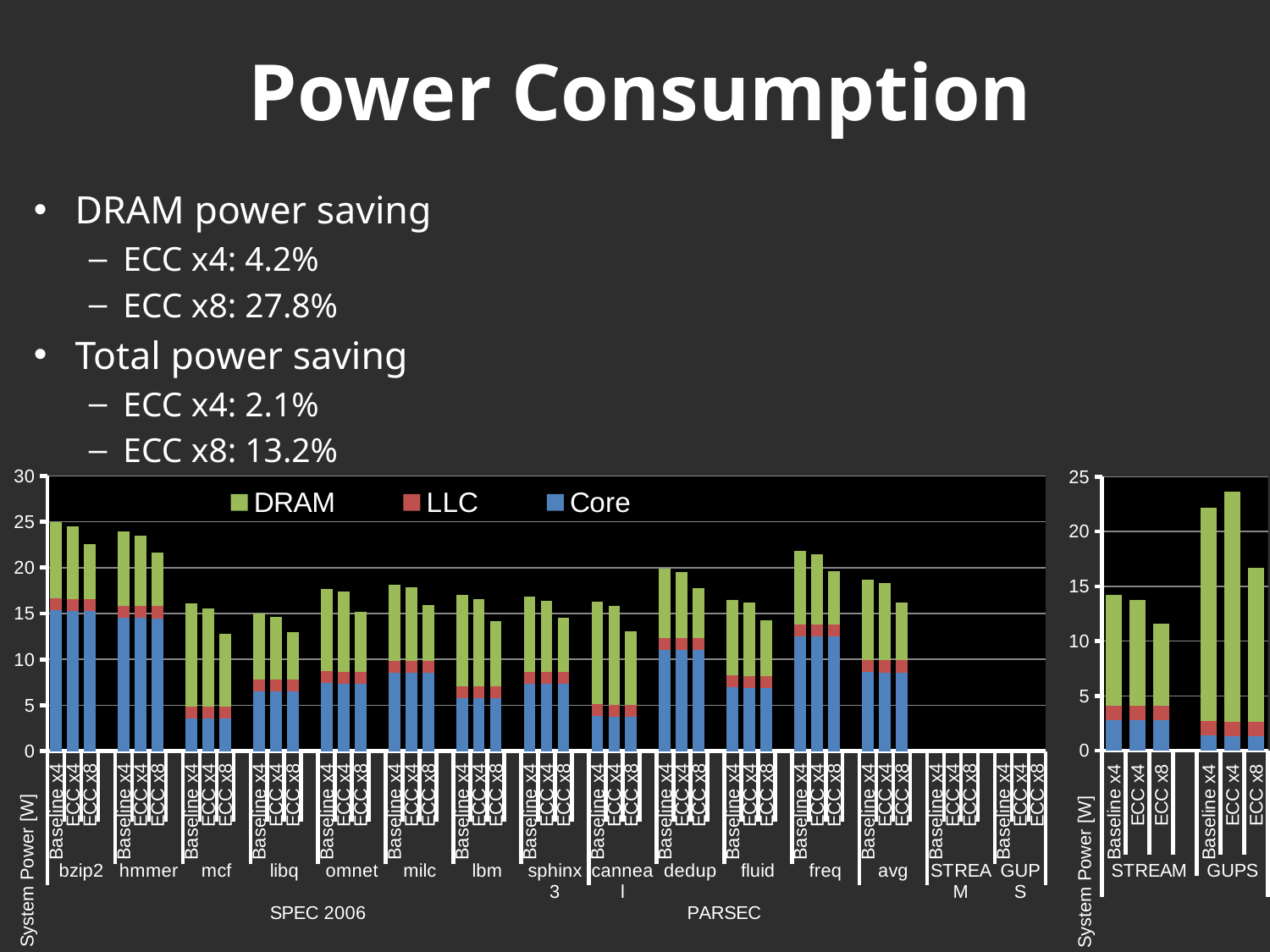
In the left chart, is the total value for the freq Baseline x4 bar greater or less than 20? greater What are the three series named in the legend of the left chart? DRAM, LLC, Core What is the y-axis title of the left chart? System Power [W] In the right chart, which bar is the tallest? GUPS ECC x4 What kind of chart is the large chart on the left of the slide? stacked bar chart In the left chart, is the total value for the mcf ECC x8 bar greater or less than 15? less In the left chart, do the bzip2 bars rise or fall going from Baseline x4 to ECC x8? fall In the right chart, which bar is the shortest? STREAM ECC x8 In the left chart, is the total value for the bzip2 Baseline x4 bar greater or less than 20? greater How many series does the legend of the left chart list? 3 In the left chart, which is larger: the bzip2 Baseline x4 bar or the mcf Baseline x4 bar? bzip2 Baseline x4